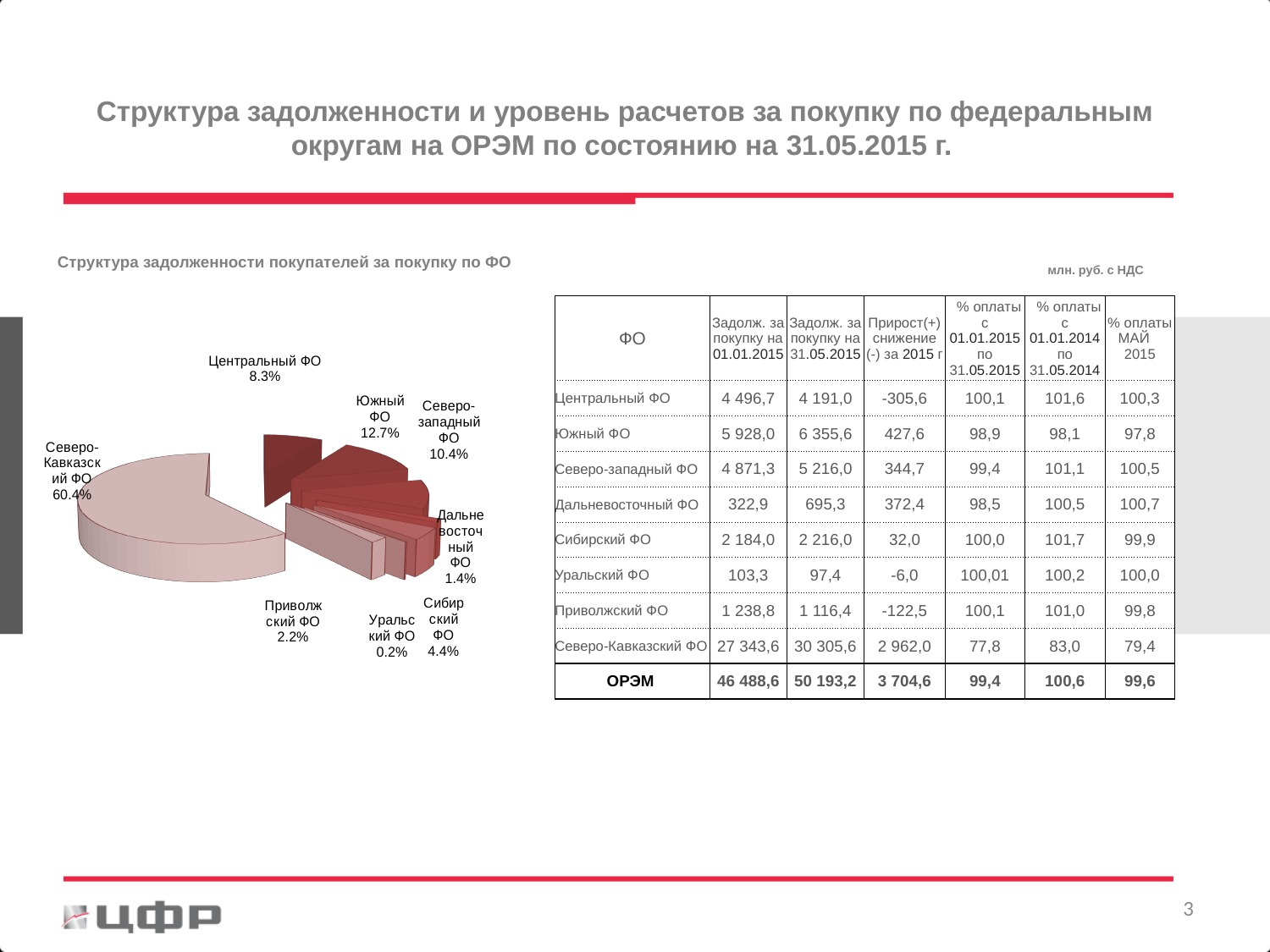
What share of the pie does Северо-Кавказский ФО have? 60.4% Which slice is larger: Южный ФО or Северо-западный ФО? Южный ФО What share of the pie does Южный ФО have? 12.7% Which federal district has the largest slice of the pie? Северо-Кавказский ФО Which federal district has the smallest slice of the pie? Уральский ФО What is the difference in percentage points between the Сибирский ФО slice and the Приволжский ФО slice? 2.2% What share of the pie does Северо-западный ФО have? 10.4% What share of the pie does Центральный ФО have? 8.3% What is the title of the pie chart? Структура задолженности покупателей за покупку по ФО What share of the pie does Уральский ФО have? 0.2% What kind of chart is shown on the slide? Pie chart How many slices does the pie chart have? 8